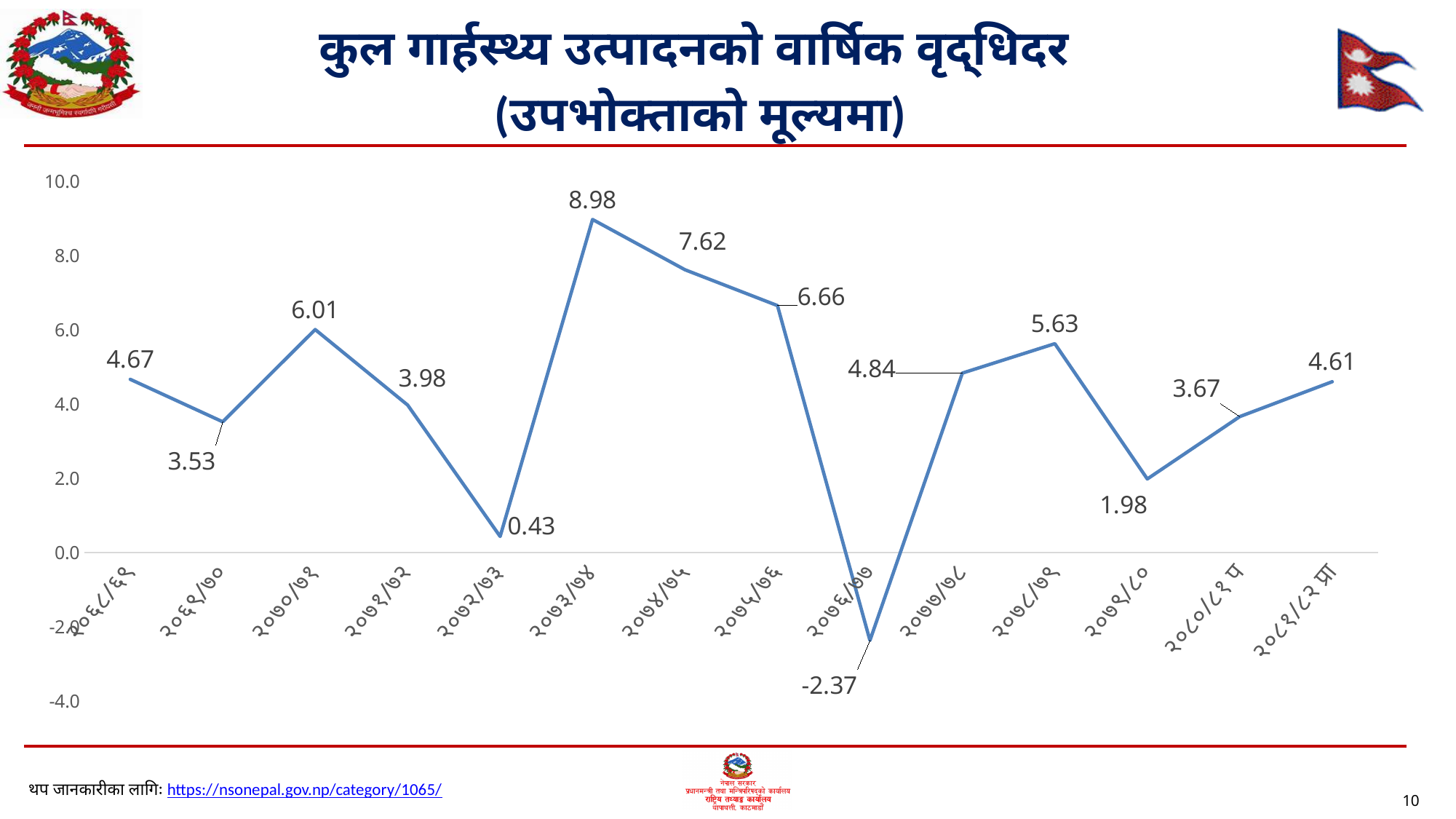
Does the value rise or fall from २०७५/७६ to २०७६/७७? fall How many years are plotted on the chart? 14 What is the value for २०७६/७७? -2.37 What is the value for २०७२/७३? 0.43 What is the value for २०७३/७४? 8.98 Which is larger, the value for २०७८/७९ or the value for २०७७/७८? २०७८/७९ Which year has the highest value? २०७३/७४ Is the value for २०७९/८० greater or less than 4.0? less What kind of chart is shown on the slide? line chart What is the difference between the values for २०७३/७४ and २०७४/७५? 1.36 Which year has the lowest value? २०७६/७७ What is the value for २०८१/८२ प्रा? 4.61